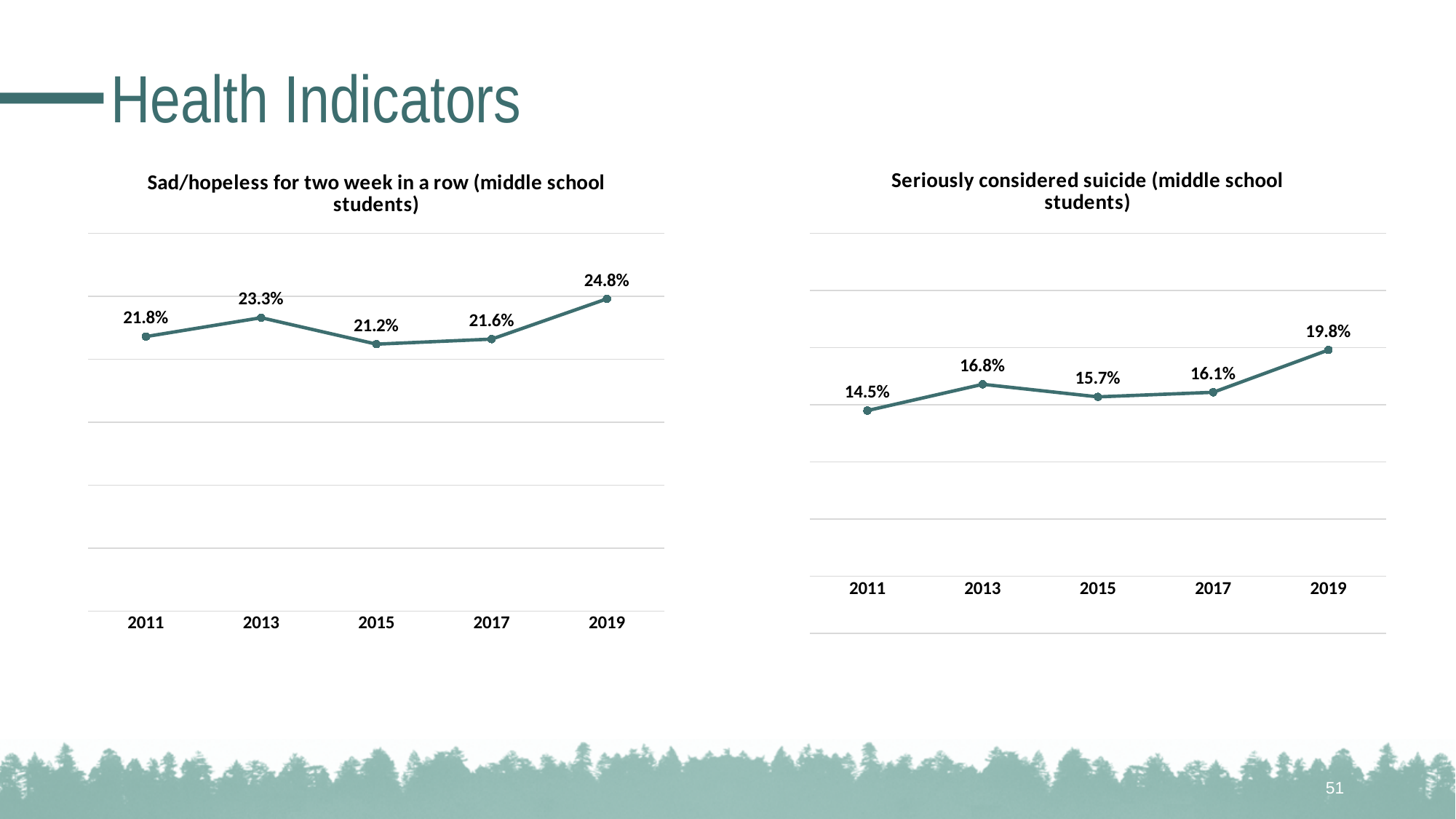
What is the title of the chart on the left side of the slide? Sad/hopeless for two week in a row (middle school students) What kind of chart is the 'Sad/hopeless for two week in a row (middle school students)' chart? Line chart In the 'Sad/hopeless for two week in a row (middle school students)' chart, which year has the highest value? 2019 How many years are plotted in the 'Seriously considered suicide (middle school students)' chart? 5 In the 'Seriously considered suicide (middle school students)' chart, which year has the lowest value? 2011 In the 'Seriously considered suicide (middle school students)' chart, what is the difference between the 2019 and 2017 values? 3.7% In the 'Seriously considered suicide (middle school students)' chart, what is the value for 2011? 14.5% In the 'Sad/hopeless for two week in a row (middle school students)' chart, what is the value for 2015? 21.2% In the 'Sad/hopeless for two week in a row (middle school students)' chart, which is larger, the value for 2013 or the value for 2017? 2013 In the 'Seriously considered suicide (middle school students)' chart, which is larger, the value for 2013 or the value for 2015? 2013 In the 'Sad/hopeless for two week in a row (middle school students)' chart, what is the difference between the 2019 and 2011 values? 3.0% In the 'Seriously considered suicide (middle school students)' chart, does the value rise or fall from 2017 to 2019? Rise